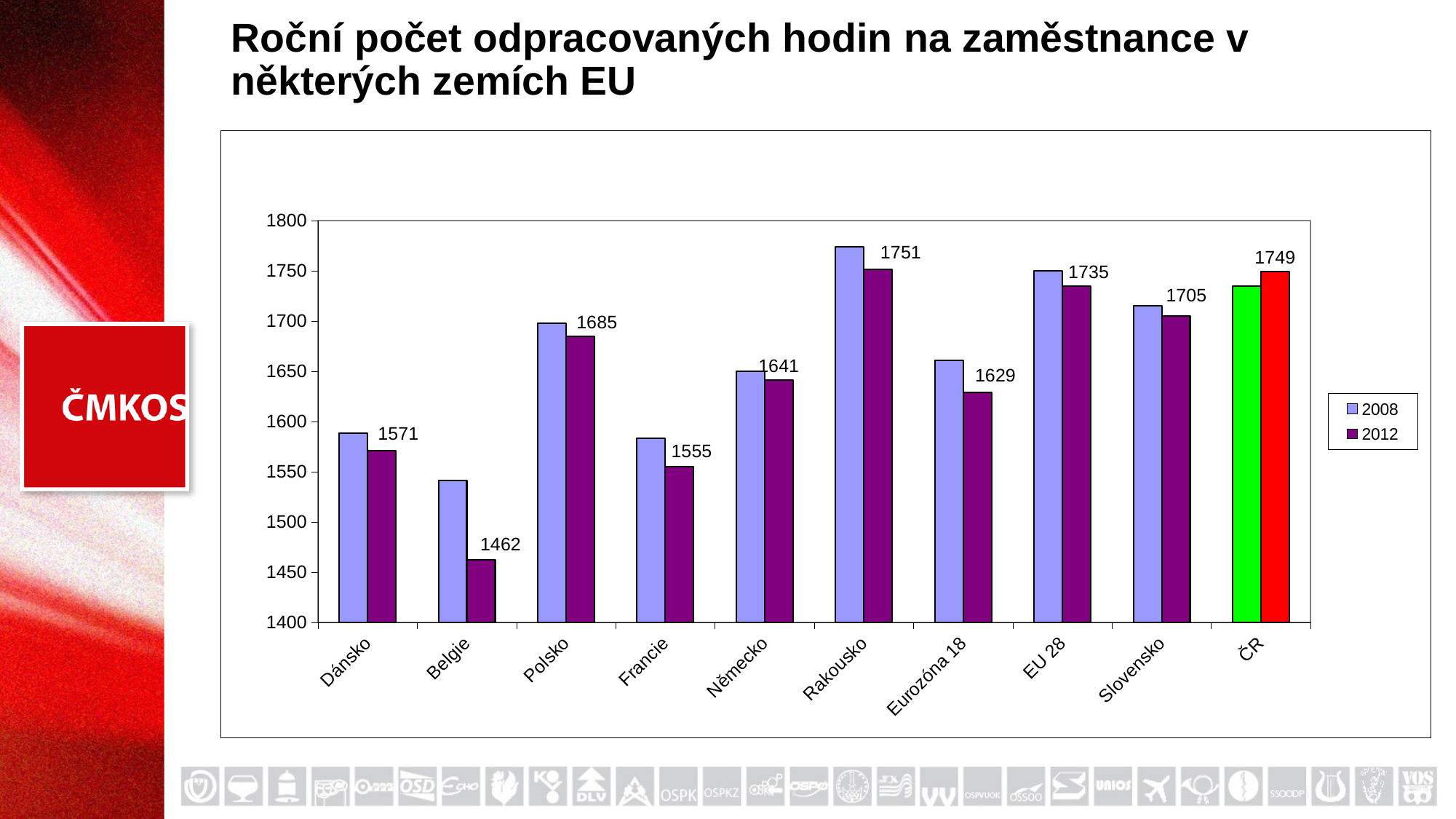
How many categories are shown on the x axis? 10 What is the difference between the 2012 values for Rakousko and Belgie? 289 What is the 2012 value for ČR? 1749 Which has the larger 2012 value, Polsko or Slovensko? Slovensko Which category has the highest 2012 value? Rakousko Is the 2008 value for Dánsko greater or less than 1600? less What is the 2012 value for Rakousko? 1751 Which country has the lowest 2012 value? Belgie Is the 2008 value for Rakousko greater or less than 1750? greater What is the 2012 value for Belgie? 1462 What kind of chart is shown on the slide? bar chart How many series does the legend list? 2